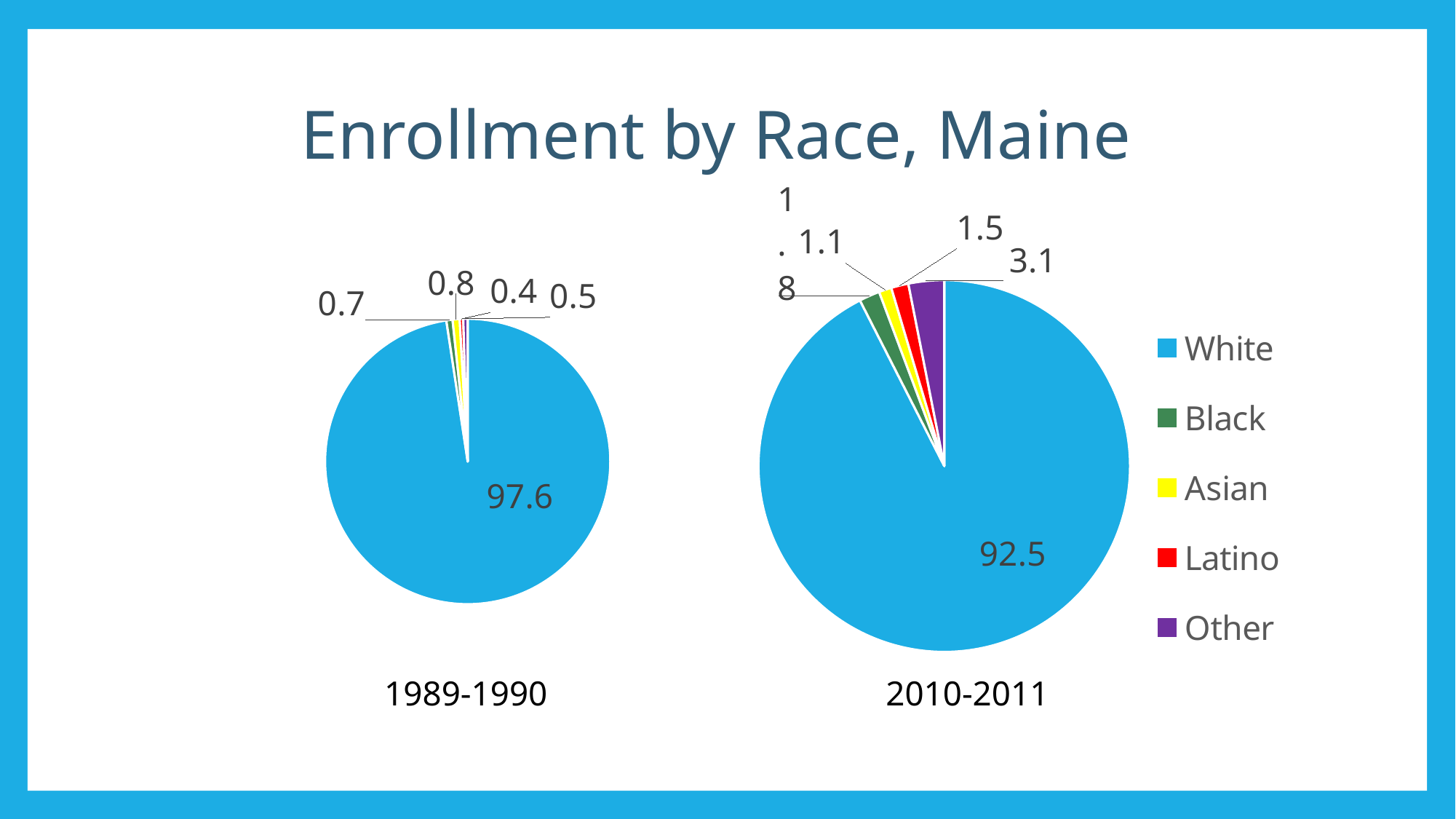
In the 1989-1990 pie chart, what is the value for White? 97.6 What is the difference between the White value in the 1989-1990 pie chart and the White value in the 2010-2011 pie chart? 5.1 In the 2010-2011 pie chart, what is the value for White? 92.5 How many categories does the legend list? 5 In the 1989-1990 pie chart, what is the value for Latino? 0.4 How many slices does the 2010-2011 pie chart have? 5 What kind of charts are shown on the slide? Pie charts In the 2010-2011 pie chart, which category has the largest slice? White In the 1989-1990 pie chart, which category has the smallest slice? Latino In the 2010-2011 pie chart, what is the value for Other? 3.1 In the 1989-1990 pie chart, what is the value for Asian? 0.8 In the 2010-2011 pie chart, which is larger, Other or Latino? Other